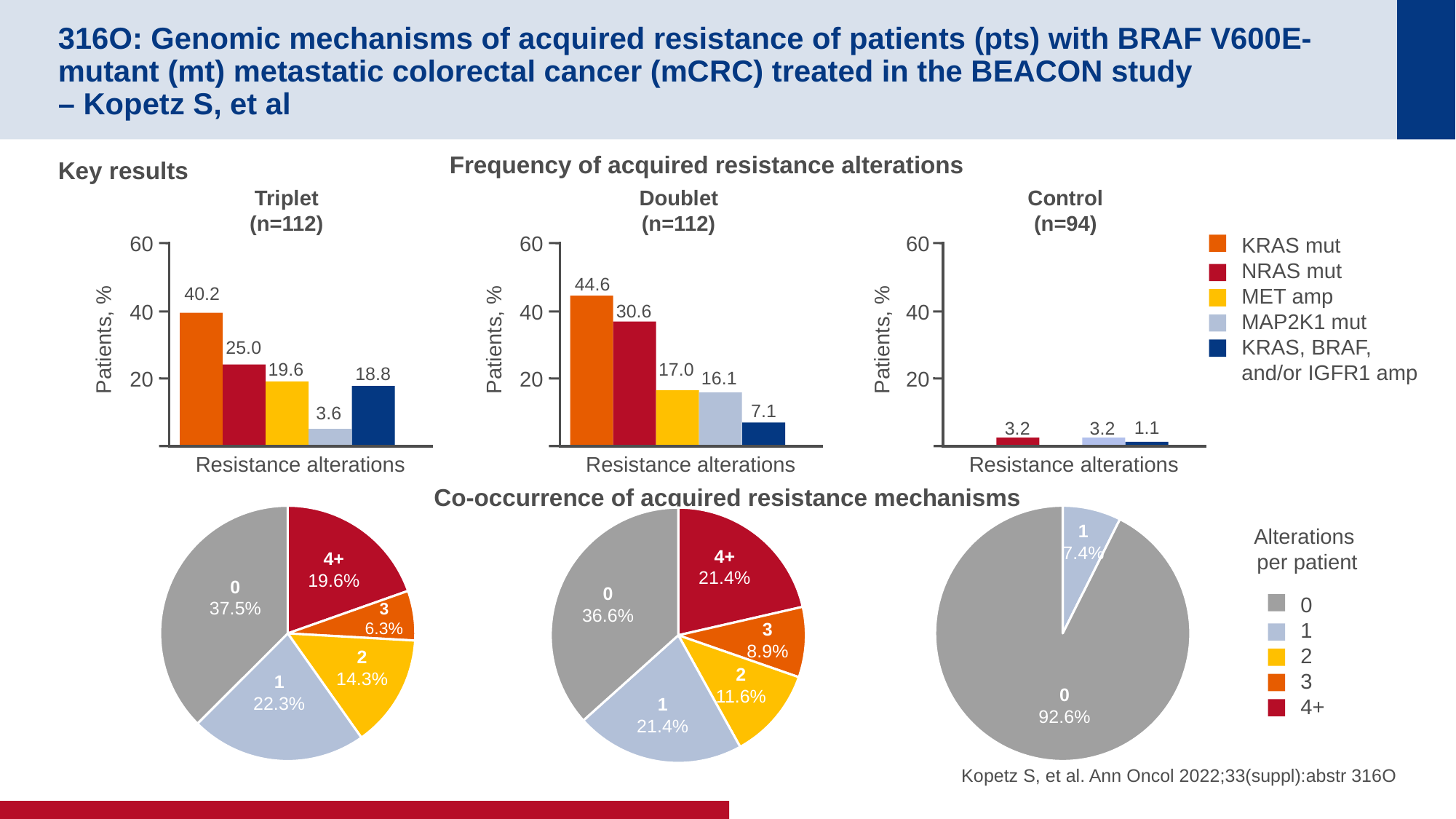
In the Doublet co-occurrence pie chart, what share of patients had 4+ alterations? 21.4% In the Triplet (n=112) bar chart, which resistance alteration has the lowest value? MAP2K1 mut In the Triplet (n=112) bar chart, what is the difference between the KRAS mut and NRAS mut values? 15.2 In the Triplet co-occurrence pie chart, what share of patients had 0 alterations? 37.5% In the Control (n=94) bar chart, what is the value for KRAS, BRAF, and/or IGFR1 amp? 1.1 In the Doublet (n=112) bar chart, what is the value for NRAS mut? 30.6 In the Triplet (n=112) bar chart, what percentage of patients had a KRAS mutation? 40.2 What kind of chart is used for the Frequency of acquired resistance alterations section? Bar chart Is the KRAS mut value larger in the Triplet (n=112) chart or the Doublet (n=112) chart? Doublet (n=112) How many series does the legend of the Frequency of acquired resistance alterations bar charts list? 5 In the Control co-occurrence pie chart, how many slices are there? 2 In the Doublet (n=112) bar chart, which resistance alteration has the highest value? KRAS mut